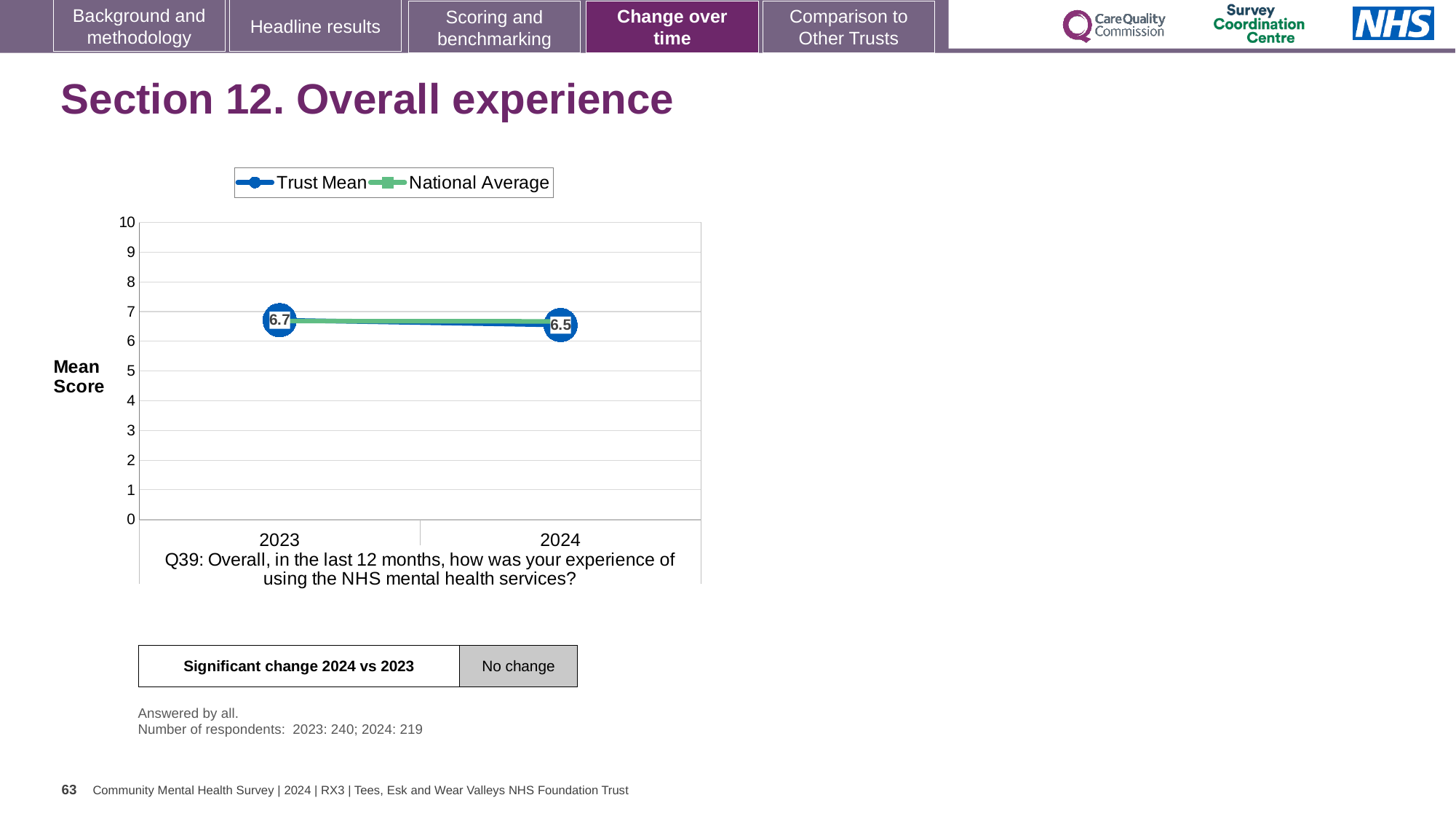
What kind of chart is shown on the slide? line chart Is the National Average value for 2024 greater or less than 5? greater What are the two series named in the legend? Trust Mean and National Average What is the Trust Mean value for 2024? 6.5 Does the Trust Mean rise or fall from 2023 to 2024? fall How many years are plotted on the x axis? 2 In which year is the Trust Mean at its lowest? 2024 By how much did the Trust Mean change from 2023 to 2024? 0.2 What is the Trust Mean value for 2023? 6.7 What is the label on the y axis of the chart? Mean Score How many series does the legend list? 2 Which year has the higher Trust Mean, 2023 or 2024? 2023